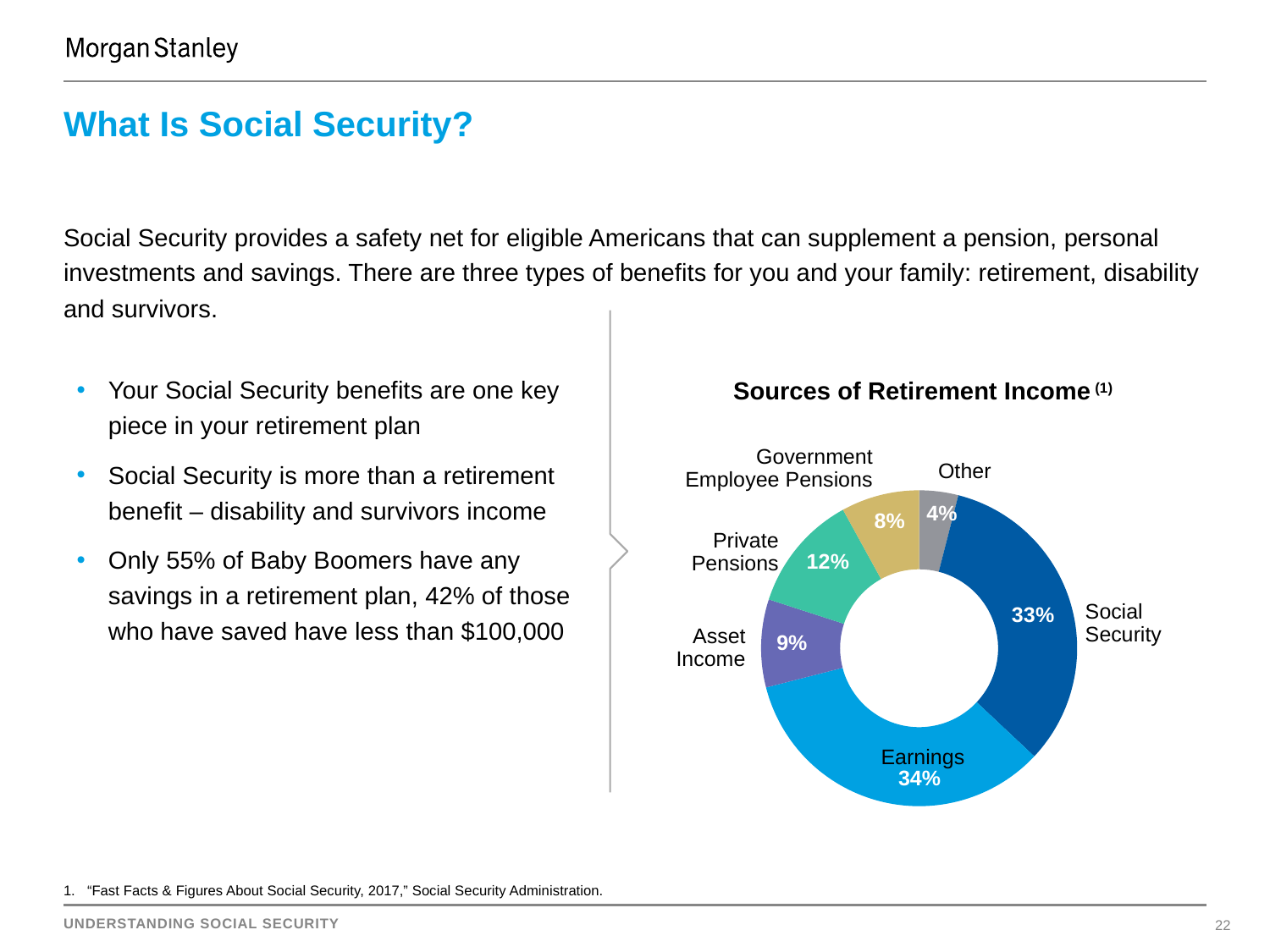
Which source of retirement income has the smallest share in the chart? Other What is the title of the chart on the slide? Sources of Retirement Income Which is larger in the chart, Private Pensions or Asset Income? Private Pensions What share of retirement income comes from Social Security in the Sources of Retirement Income chart? 33% What is the difference in percentage points between Earnings and Social Security? 1 percentage point Which source of retirement income has the largest share in the chart? Earnings What type of chart is used to show Sources of Retirement Income? Doughnut chart What percentage is shown for Government Employee Pensions? 8% What share does Asset Income represent in the chart? 9% What percentage does Earnings account for in the Sources of Retirement Income chart? 34% How many sources of retirement income are shown in the chart? 6 What is the value shown for Private Pensions in the Sources of Retirement Income chart? 12%